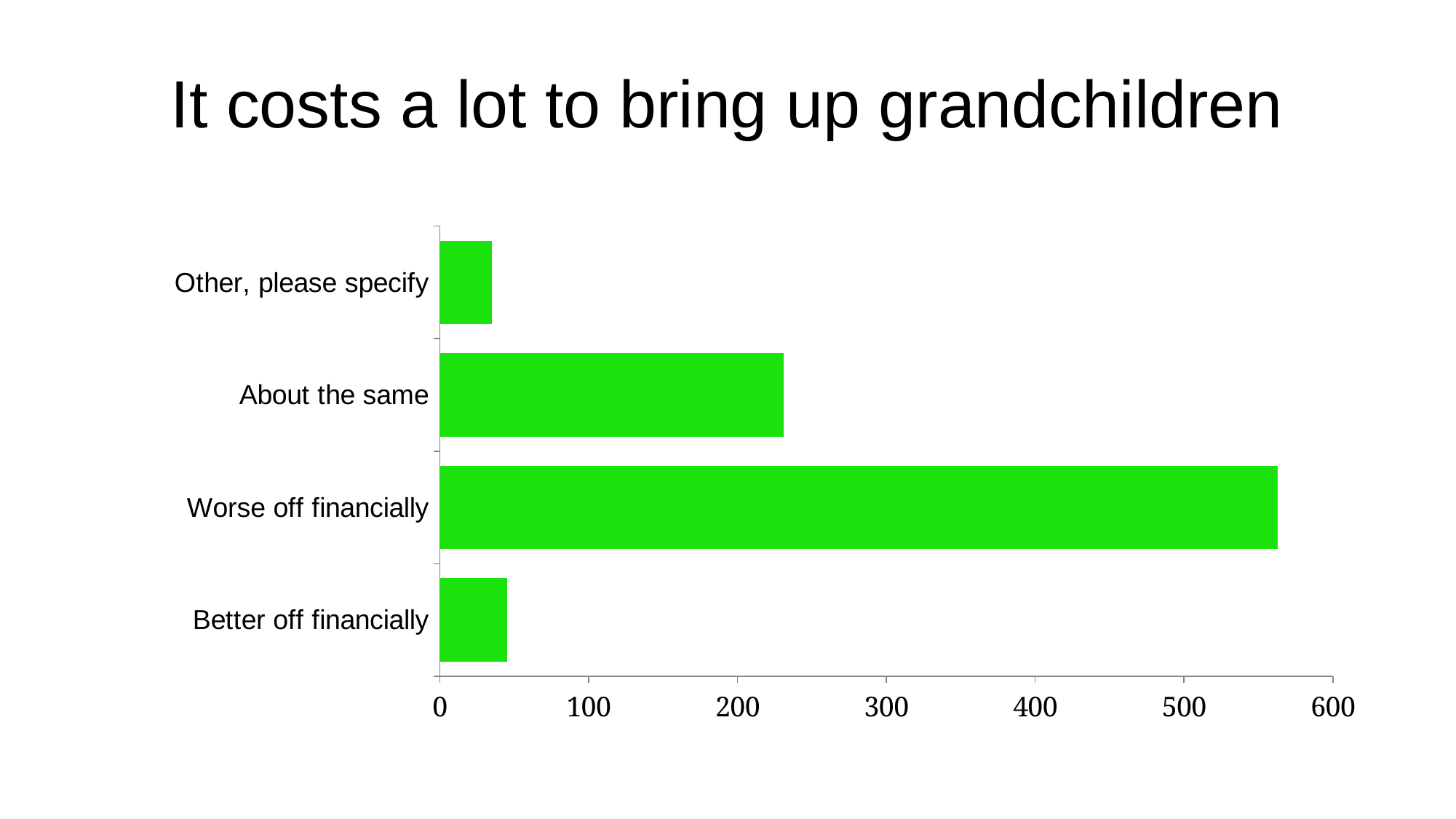
Is the value for Better off financially greater or less than 100? less Which is larger, the value for Worse off financially or the value for About the same? Worse off financially Is the value for Other, please specify greater or less than 100? less Which category has the lowest value? Other, please specify What kind of chart is shown on the slide? bar chart Is the value for Worse off financially greater or less than 500? greater What is the title of the slide? It costs a lot to bring up grandchildren Which is larger, the value for About the same or the value for Better off financially? About the same Which category has the highest value? Worse off financially What is the maximum value shown on the horizontal axis? 600 How many categories are shown in the chart? 4